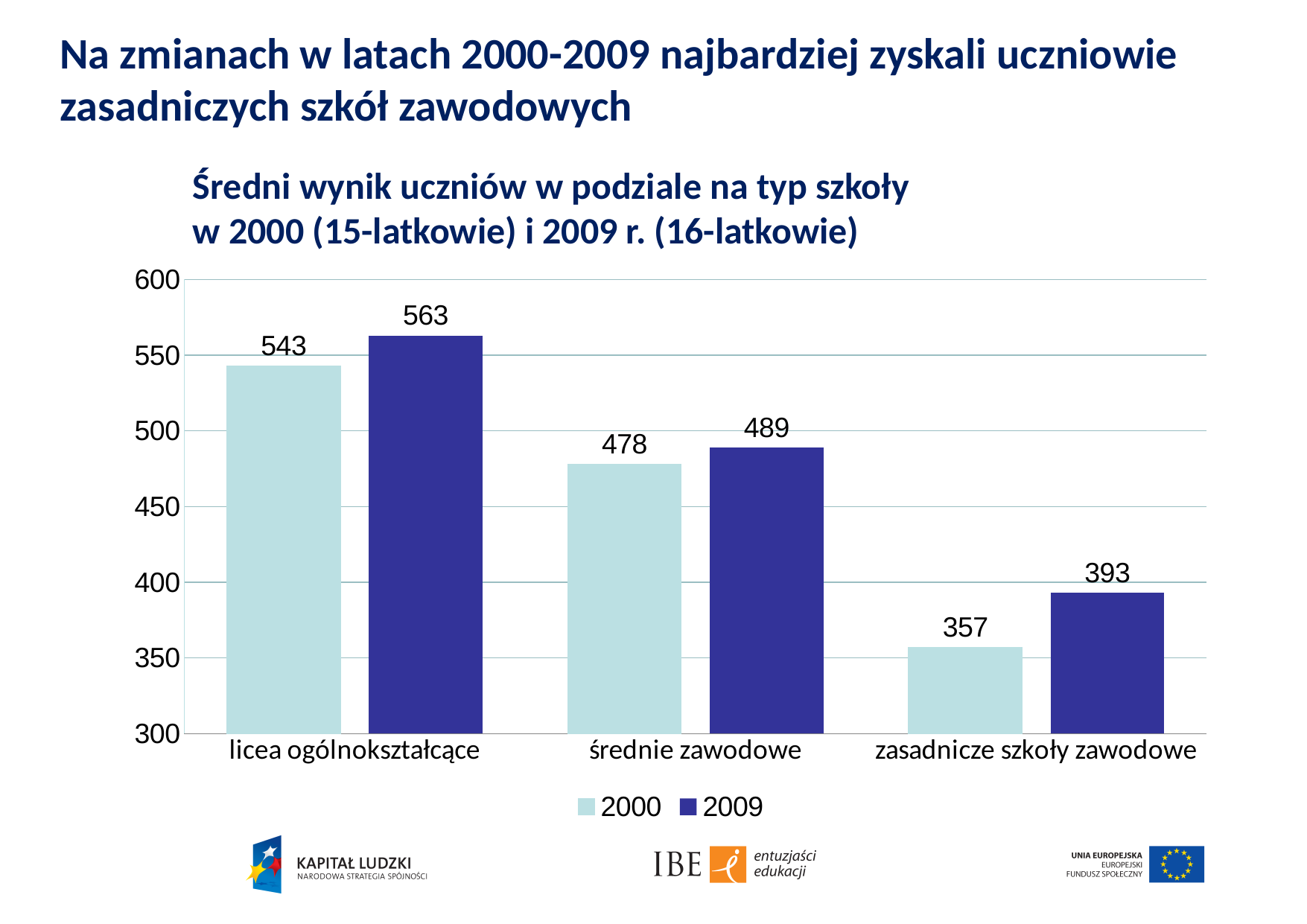
What is the value for zasadnicze szkoły zawodowe in the 2009 series? 393 What kind of chart is shown on the slide? bar chart Which category has the highest value in the 2009 series? licea ogólnokształcące Is the 2009 value for średnie zawodowe greater or less than 450? greater What is the value for średnie zawodowe in the 2000 series? 478 How many series does the legend list? 2 Which is larger: the 2009 value for średnie zawodowe or the 2000 value for licea ogólnokształcące? the 2000 value for licea ogólnokształcące How many school-type categories are shown on the x axis? 3 Which category has the lowest value in the 2000 series? zasadnicze szkoły zawodowe What is the difference between the 2009 and 2000 values for zasadnicze szkoły zawodowe? 36 What is the difference between the 2009 and 2000 values for licea ogólnokształcące? 20 What is the value for licea ogólnokształcące in the 2000 series? 543